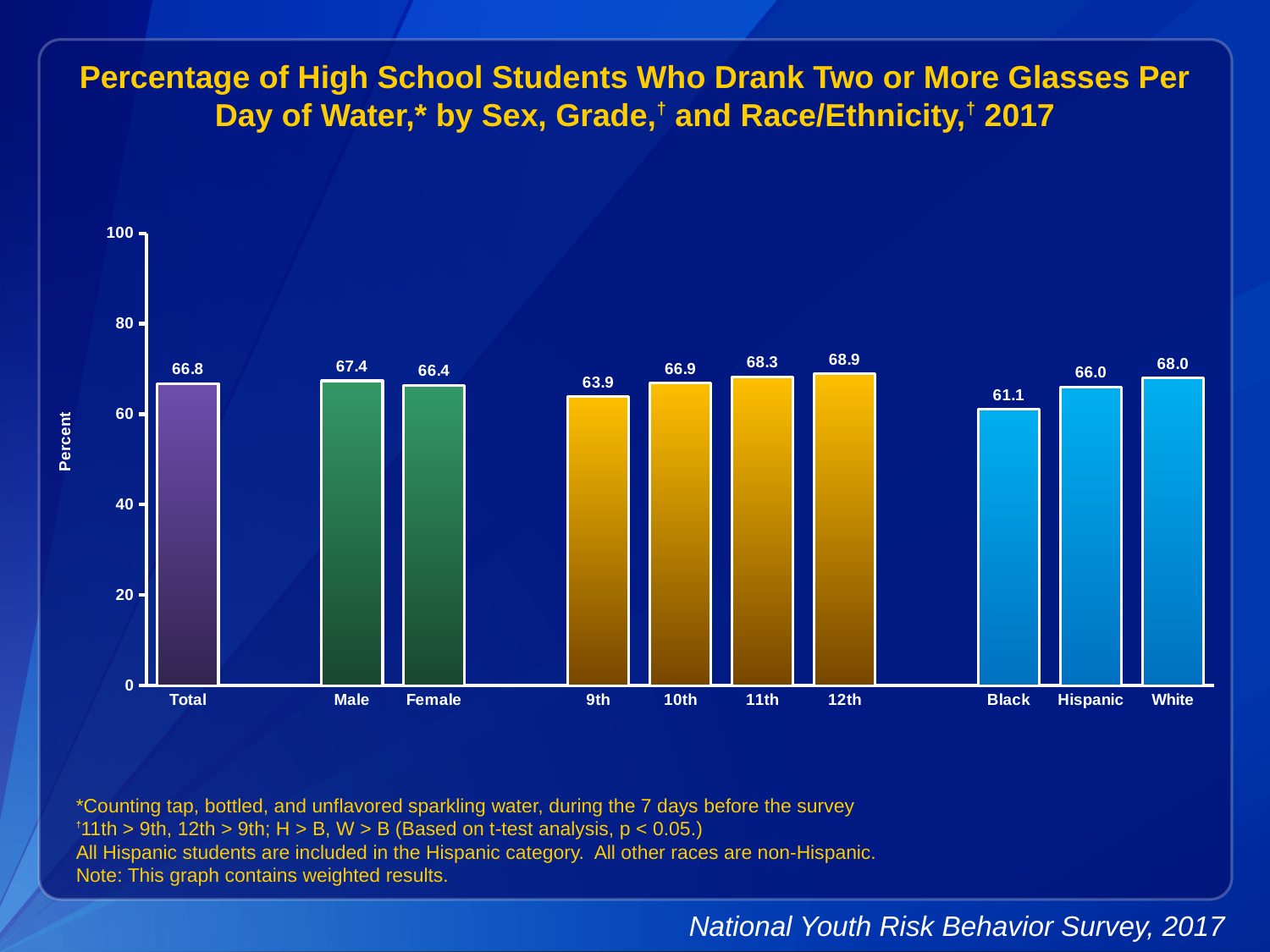
Which category has the lowest value? Black What is the value for Black students? 61.1 Which is larger, the value for 11th grade or 10th grade? 11th What is the value for Female? 66.4 What is the value for Total? 66.8 What is the difference between the values for Male and Female? 1.0 What is the difference between the values for White and Black? 6.9 Do the values rise or fall from 9th grade to 12th grade? rise Which category has the highest value? 12th How many bars are shown in the chart? 10 What is the value for 9th grade? 63.9 What kind of chart is this? bar chart